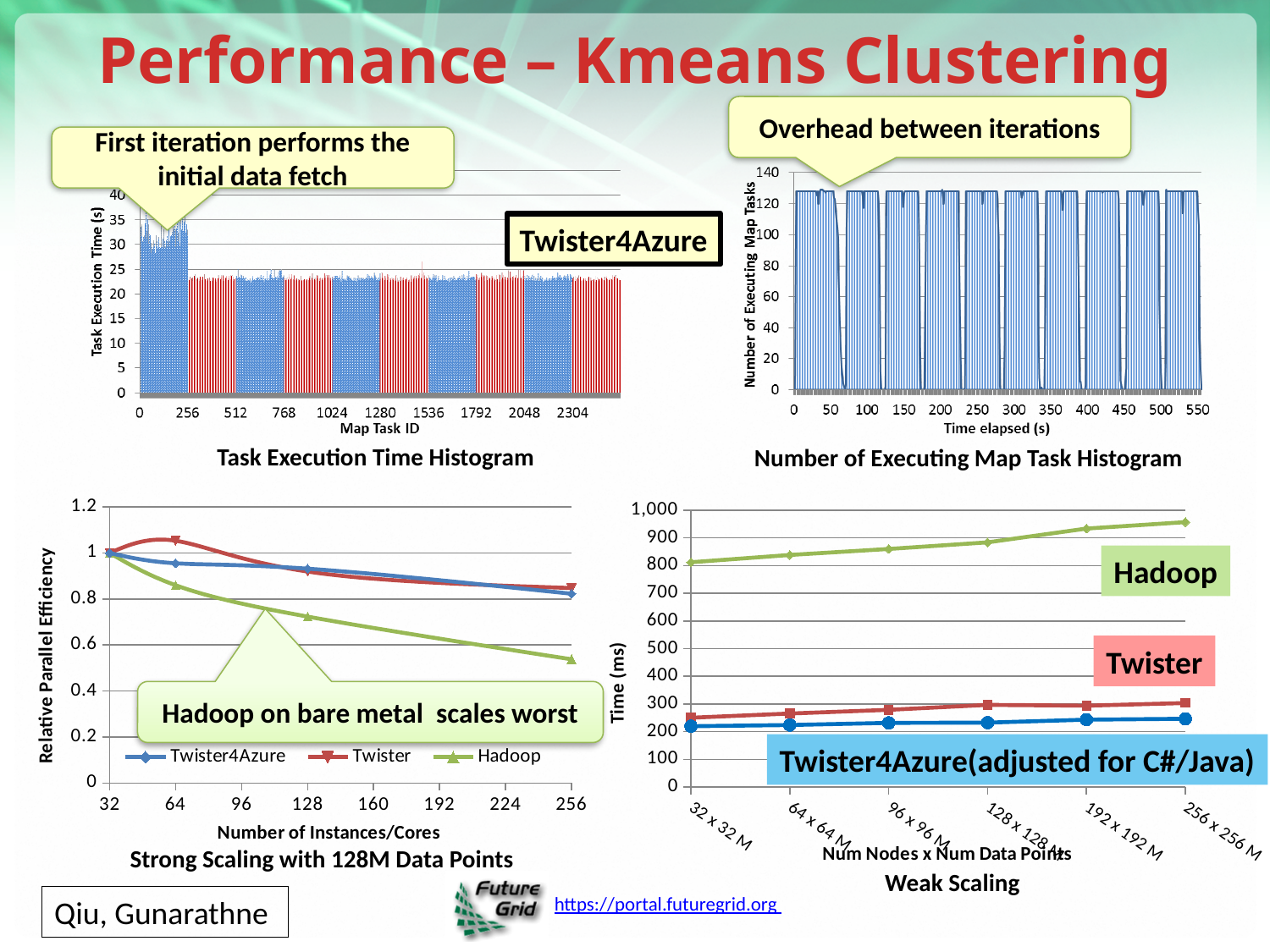
In the Weak Scaling chart, which series has the highest time at 256 x 256 M? Hadoop What kind of chart is the Task Execution Time Histogram (top-left)? bar chart In the Number of Executing Map Task Histogram (top-right), is the peak number of executing map tasks greater or less than 140? less In the Strong Scaling with 128M Data Points chart, which series has the lowest relative parallel efficiency at 256 instances/cores? Hadoop In the Weak Scaling chart, does the Hadoop series rise or fall from 32 x 32 M to 256 x 256 M? rise In the Strong Scaling with 128M Data Points chart, is the Hadoop value at 256 instances/cores greater or less than 0.6? less In the Weak Scaling chart, is the Hadoop value at 256 x 256 M greater or less than 900? greater In the Strong Scaling with 128M Data Points chart, which series has the highest relative parallel efficiency at 64 instances/cores? Twister In the Strong Scaling with 128M Data Points chart, does the Hadoop series rise or fall as the number of instances/cores increases? fall What kind of chart is the Strong Scaling with 128M Data Points chart (bottom-left)? line chart How many series does the legend of the Strong Scaling with 128M Data Points chart list? 3 How many categories are shown on the x axis of the Weak Scaling chart (bottom-right)? 6